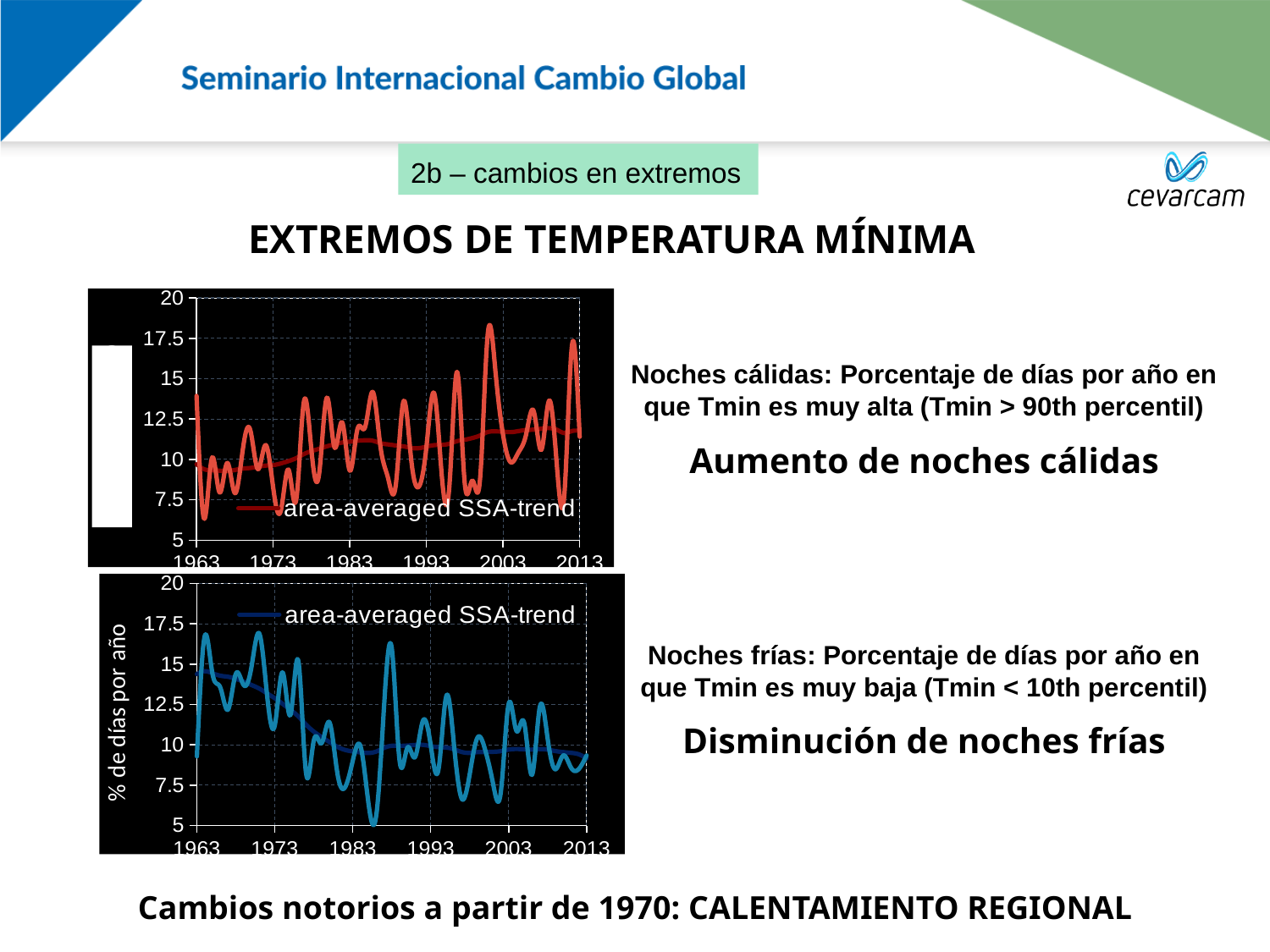
In the bottom chart, is the value of the SSA-trend line at 2013 greater or less than 12.5? less In the bottom chart, does the area-averaged SSA-trend line rise or fall from 1963 to 2013? fall In the bottom chart, is the highest peak of the blue line (around 1965) greater or less than 15? greater What kind of chart is the top chart (red line)? line chart In the top chart, is the highest peak of the red line (around 2001) greater or less than 15? greater What is the legend entry shown in the bottom chart? area-averaged SSA-trend What is the first year shown on the x axis of the bottom chart? 1963 How many year labels are shown on the x axis of the top chart? 6 How many entries does the legend of the top chart list? 1 What is the y-axis label of the bottom chart? % de días por año In the top chart, does the area-averaged SSA-trend line rise or fall from 1963 to 2013? rise What kind of chart is the bottom chart (blue line)? line chart